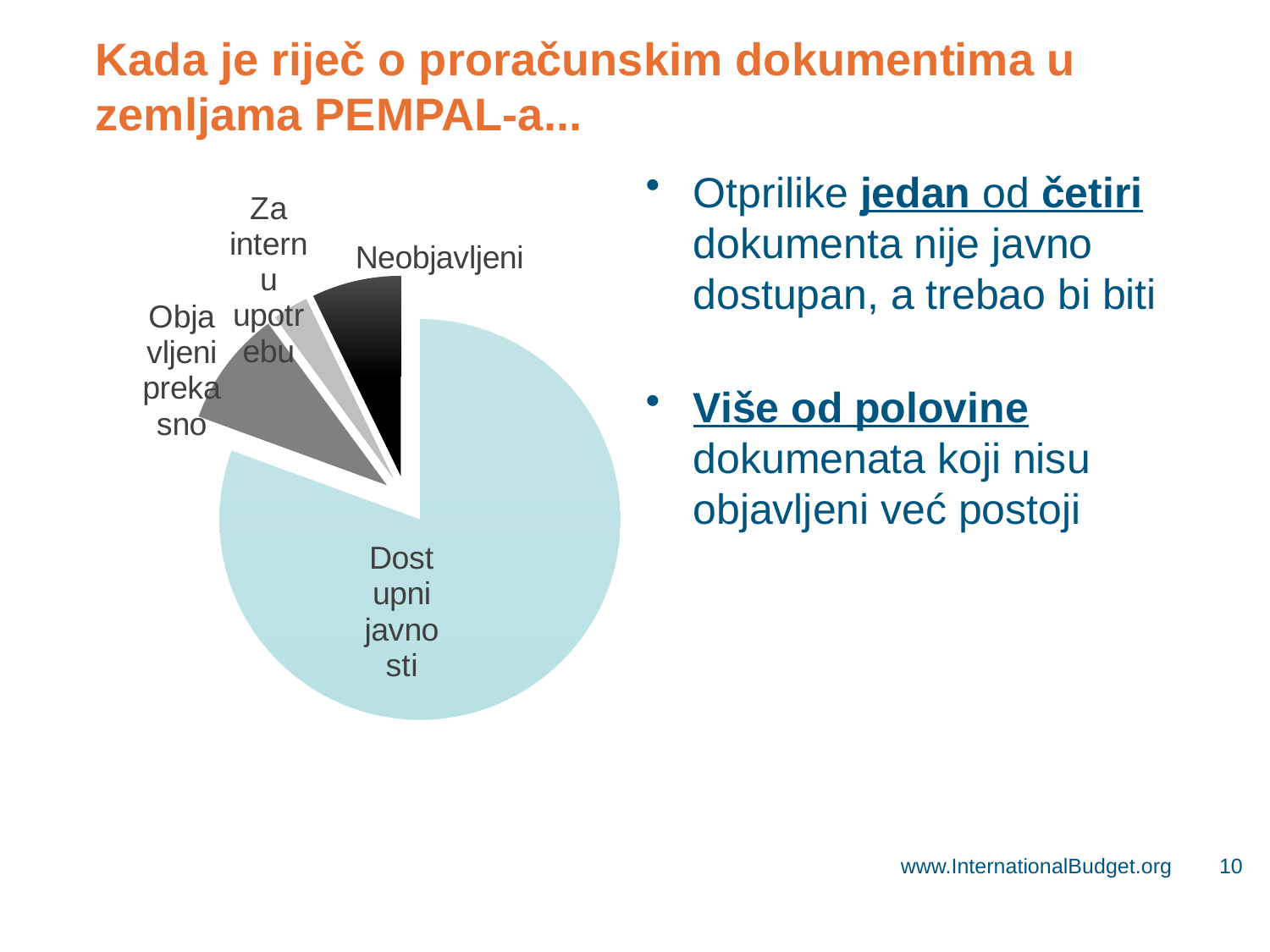
What colour is the largest slice of the pie chart? light blue Which slice of the pie chart is the largest? Dostupni javnosti Does the Dostupni javnosti slice take up more or less than half of the pie? more What colour is the Neobjavljeni slice of the pie chart? black What kind of chart is shown on the slide? pie chart How many slices does the pie chart have? 4 Which slice is larger, Neobjavljeni or Za internu upotrebu? Neobjavljeni Which slice is larger, Objavljeni prekasno or Za internu upotrebu? Objavljeni prekasno Which slice is larger, Dostupni javnosti or Neobjavljeni? Dostupni javnosti Which slice of the pie chart is the smallest? Za internu upotrebu